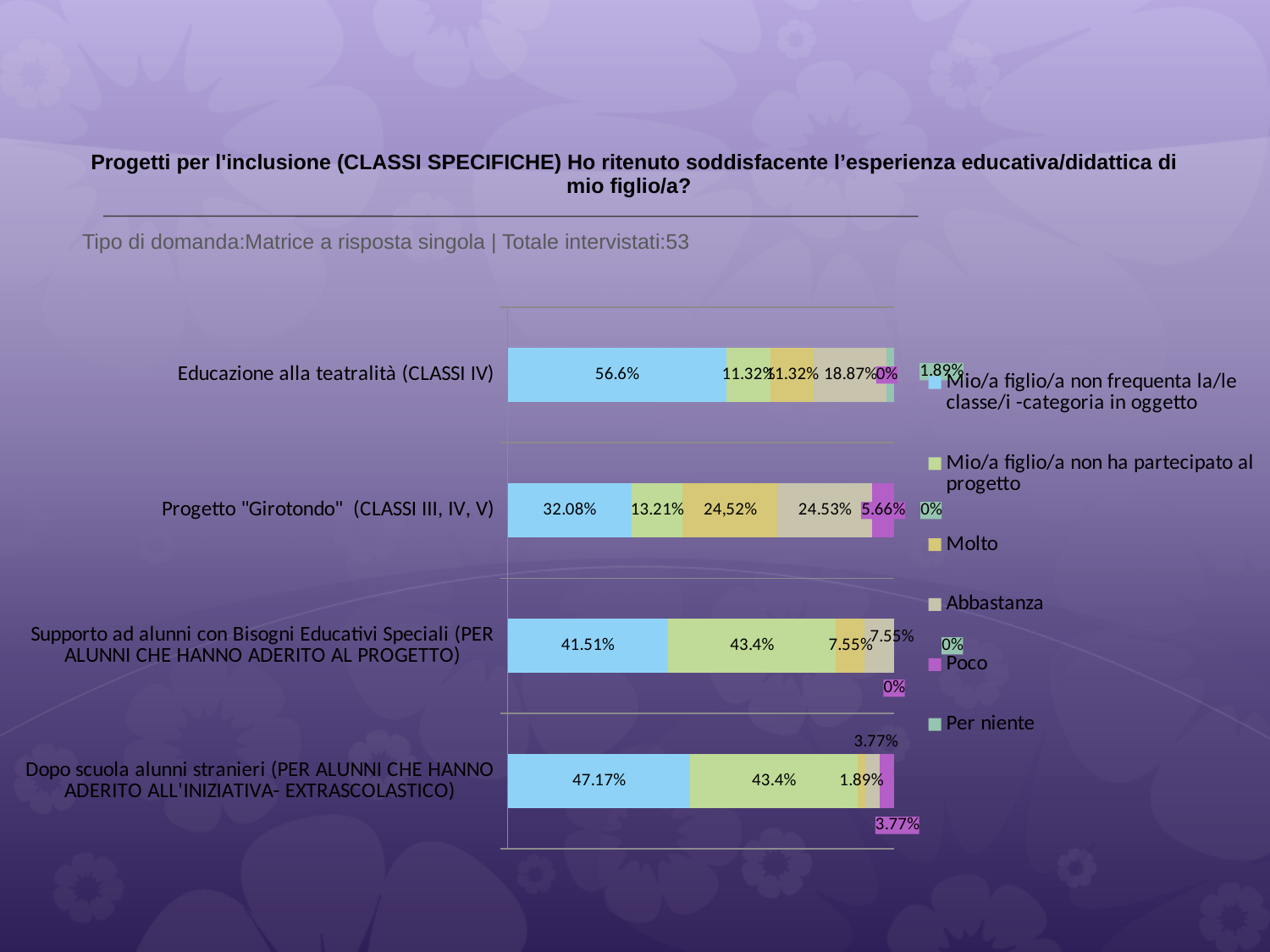
What is the value of 'Mio/a figlio/a non frequenta la/le classe/i -categoria in oggetto' for 'Educazione alla teatralità (CLASSI IV)'? 56.6% According to the subtitle, how many respondents were surveyed in total? 53 What is the 'Poco' value for 'Progetto "Girotondo" (CLASSI III, IV, V)'? 5.66% What is the 'Mio/a figlio/a non ha partecipato al progetto' value for 'Supporto ad alunni con Bisogni Educativi Speciali'? 43.4% Which has the larger 'Abbastanza' value: 'Progetto "Girotondo"' or 'Educazione alla teatralità'? Progetto "Girotondo" Which category has the highest value for 'Mio/a figlio/a non frequenta la/le classe/i -categoria in oggetto'? Educazione alla teatralità (CLASSI IV) What is the difference between the 'Mio/a figlio/a non frequenta la/le classe/i -categoria in oggetto' values for 'Educazione alla teatralità' (56.6%) and 'Dopo scuola alunni stranieri' (47.17%)? 9.43 percentage points What kind of chart is shown on the slide? Stacked bar chart What is the 'Molto' value for 'Progetto "Girotondo" (CLASSI III, IV, V)'? 24,52% What is the 'Mio/a figlio/a non frequenta la/le classe/i -categoria in oggetto' value for 'Dopo scuola alunni stranieri'? 47.17% How many project categories are plotted on the chart? 4 How many series does the legend list? 6